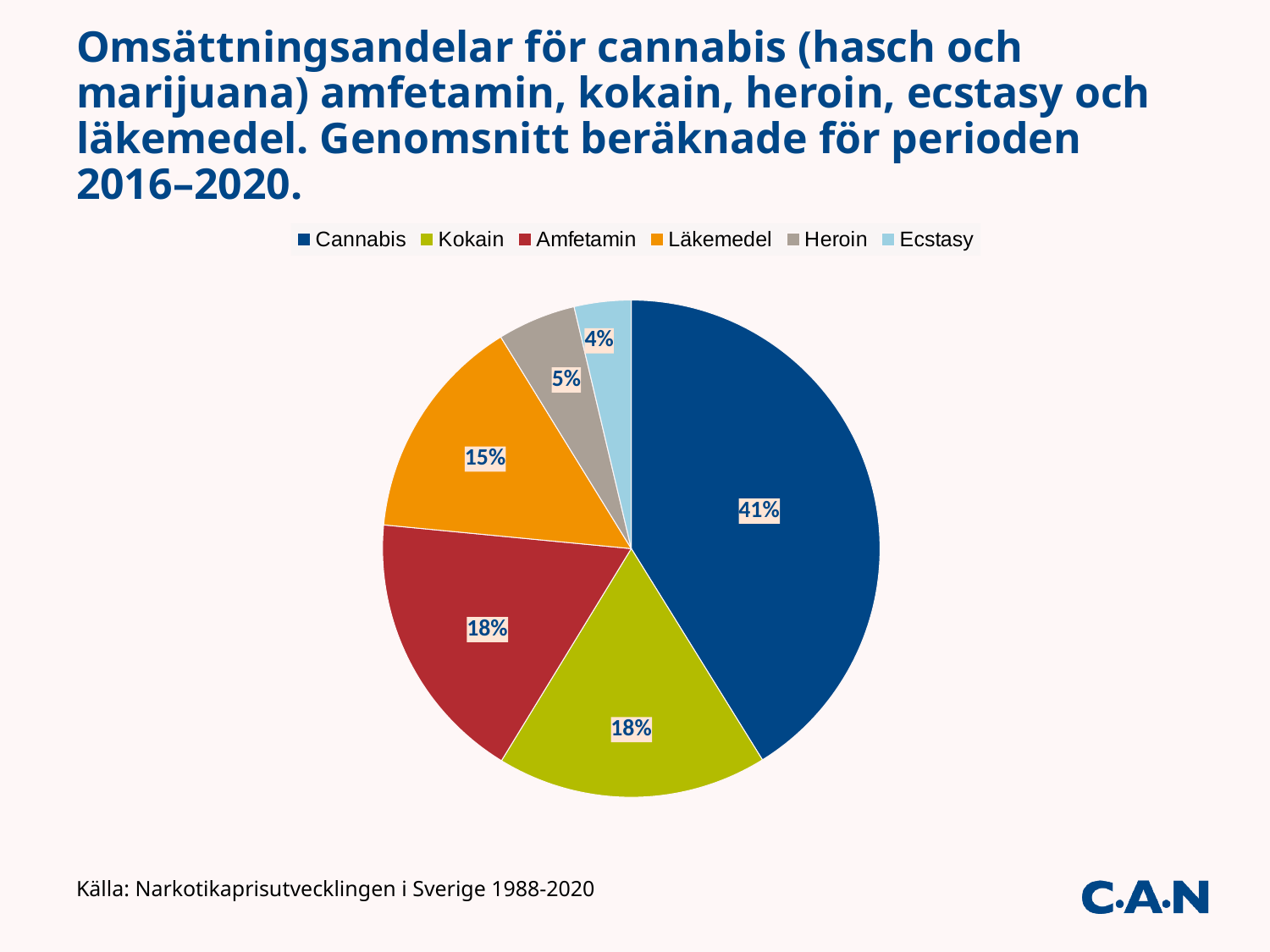
Which colour represents Läkemedel in the legend? Orange Which has a larger share, Läkemedel or Heroin? Läkemedel Which category has the smallest share of the pie? Ecstasy What share of the pie does Läkemedel account for? 15% What share of the pie does Kokain account for? 18% What share of the pie does Ecstasy account for? 4% Which category has the largest share of the pie? Cannabis What kind of chart is shown on the slide? Pie chart How many categories does the pie chart show? 6 What share of the pie does Cannabis account for? 41% What share of the pie does Heroin account for? 5% What is the difference in percentage points between the Cannabis share and the Amfetamin share? 23